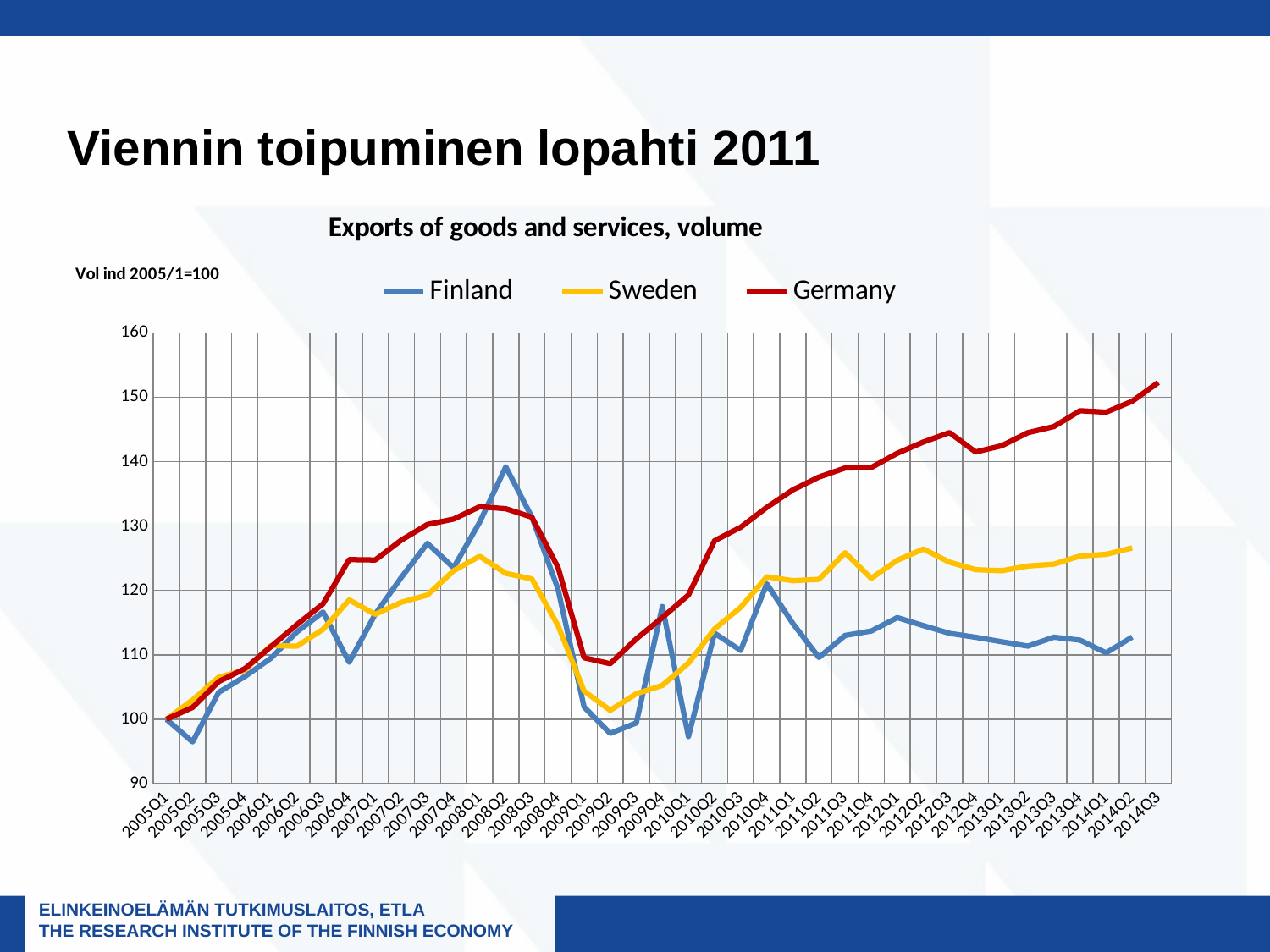
Is the value for Finland in 2009Q2 greater or less than 100? less Which series has the highest value in 2014Q3? Germany Is the value for Finland in 2008Q2 greater or less than 130? greater Which countries are listed in the chart legend? Finland, Sweden, Germany What is the title of the chart? Exports of goods and services, volume How many quarters are shown on the x axis? 39 What kind of chart is shown on the slide? line chart Is the value for Germany in 2014Q3 greater or less than 150? greater How many series does the legend list? 3